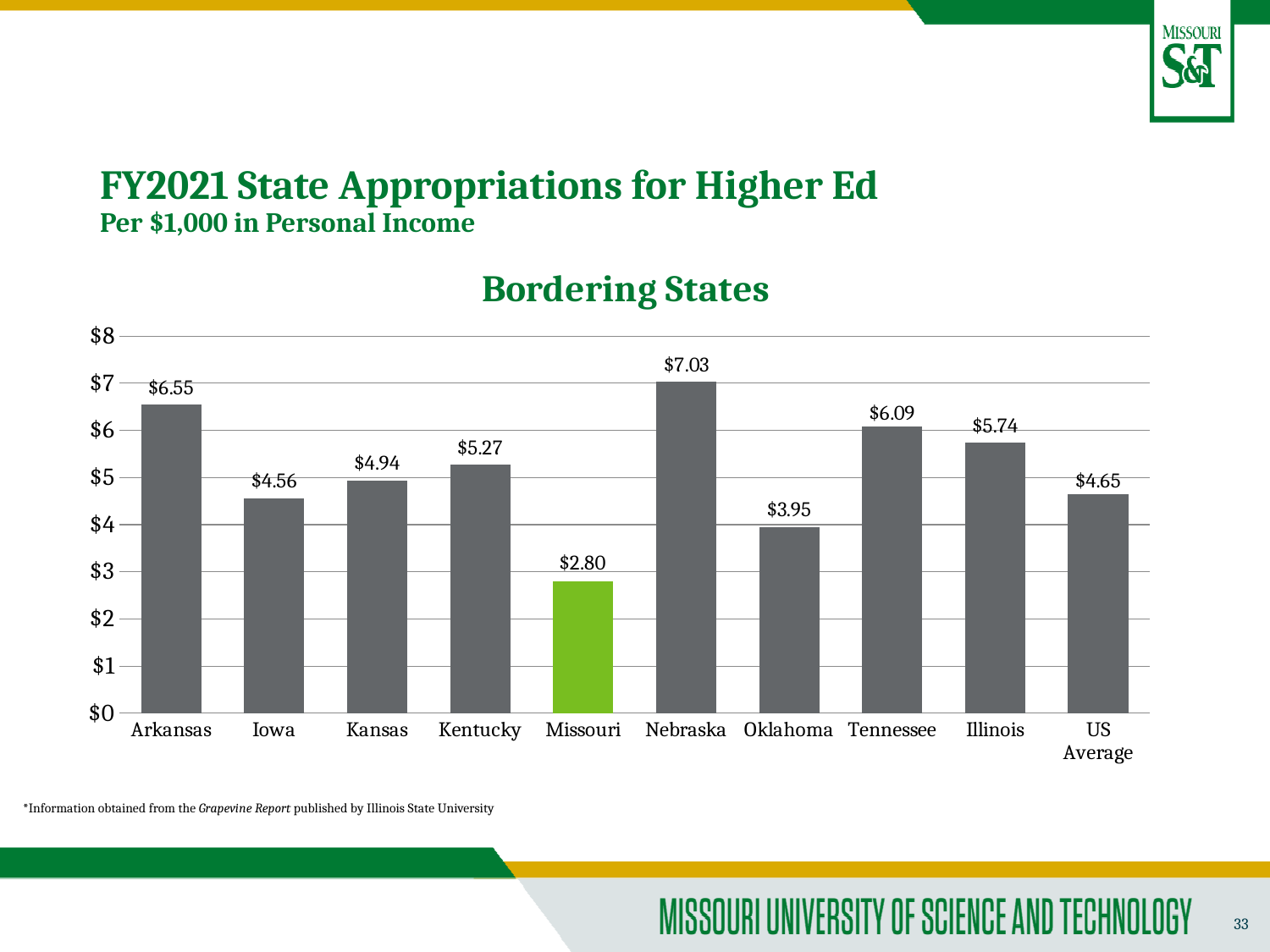
What is the difference between the values for Nebraska and Missouri? $4.23 What is the difference between the US Average and Missouri? $1.85 Is the value for Oklahoma greater or less than $4? less What is the value for the US Average? $4.65 What is the value for Nebraska? $7.03 What is the title of the chart? Bordering States Which category has the lowest value? Missouri Which is larger, the value for Tennessee or the value for Illinois? Tennessee What kind of chart is shown on the slide? bar chart Which category has the highest value? Nebraska How many categories are shown on the x axis? 10 What is the value for Missouri? $2.80